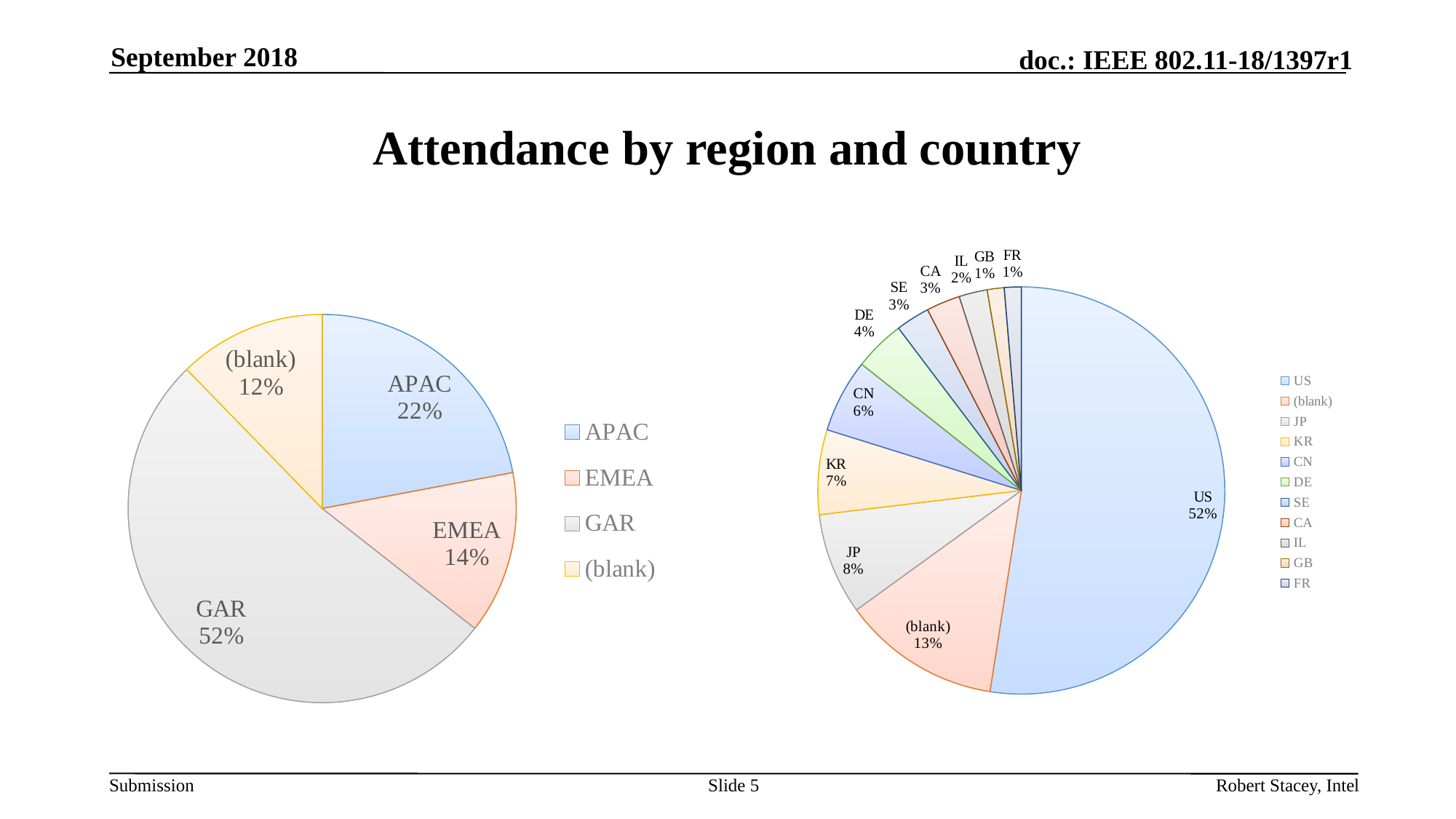
In the left pie chart (by region), what share does GAR have? 52% In the left pie chart (by region), how many slices are there? 4 In the left pie chart (by region), what share does APAC have? 22% In the right pie chart (by country), how many entries does the legend list? 11 In the left pie chart (by region), what is the difference in percentage points between APAC and EMEA? 8 In the left pie chart (by region), which region has the largest share? GAR In the right pie chart (by country), what is the difference in percentage points between (blank) and DE? 9 In the right pie chart (by country), what share does US have? 52% What type of chart is shown on the right side of the slide? Pie chart In the right pie chart (by country), which of KR or CN has the larger share? KR In the left pie chart (by region), which category has the smallest share? (blank)